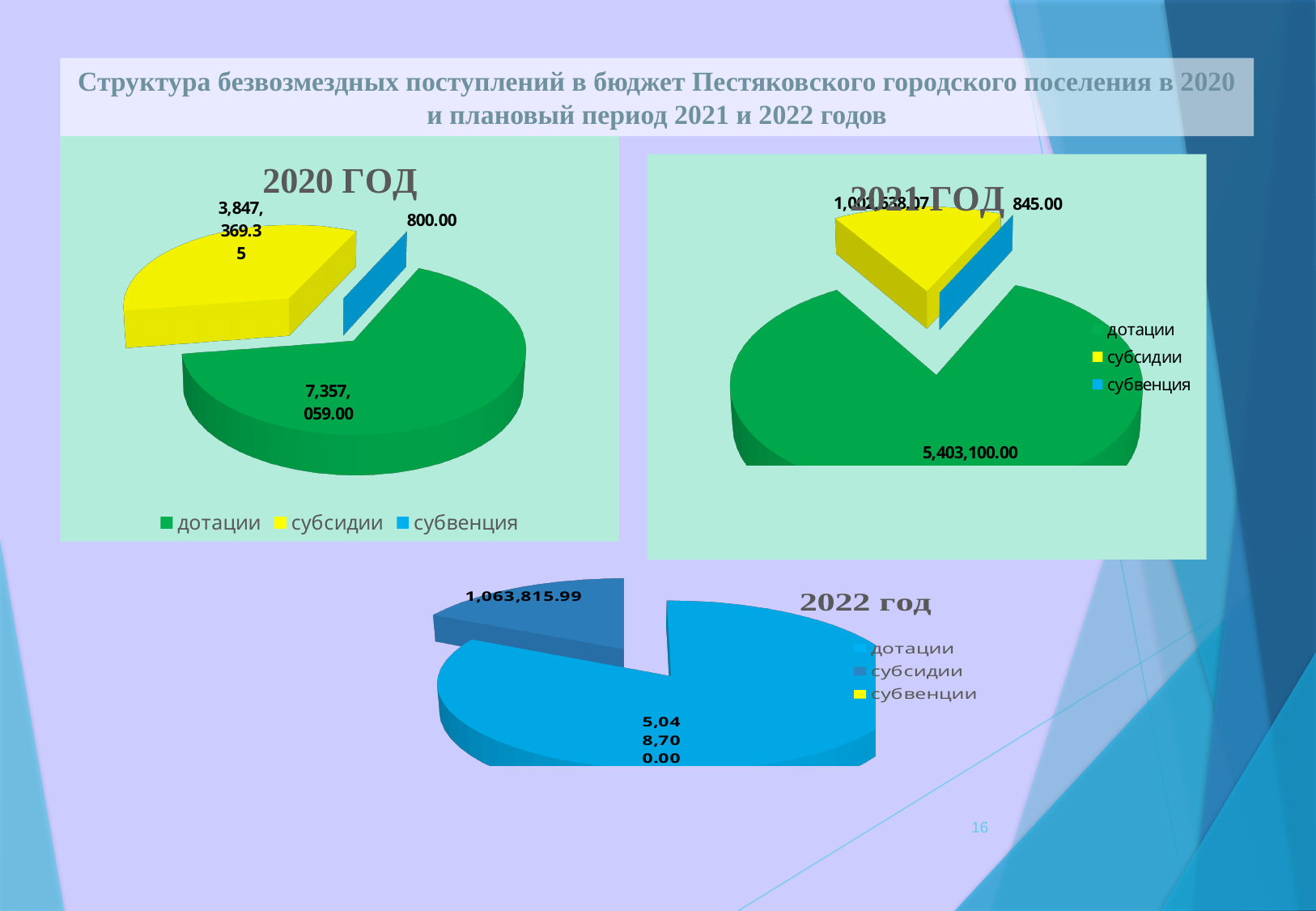
What kind of chart is the "2020 ГОД" chart? pie chart In the "2022 год" chart, what is the value for дотации? 5,048,700.00 In the "2022 год" chart, what is the value for субсидии? 1,063,815.99 In the "2020 ГОД" chart, which category has the largest value? дотации How many entries does the legend of the "2022 год" chart list? 3 In the "2020 ГОД" chart, what is the value for субвенция? 800.00 In the "2020 ГОД" chart, what is the value for дотации? 7,357,059.00 In the "2020 ГОД" chart, which category has the smallest value? субвенция In the "2020 ГОД" chart, what is the value for субсидии? 3,847,369.35 In the "2021 ГОД" chart, what is the value for субвенция? 845.00 In the "2021 ГОД" chart, what is the value for дотации? 5,403,100.00 In the "2021 ГОД" chart, which is larger, дотации or субвенция? дотации